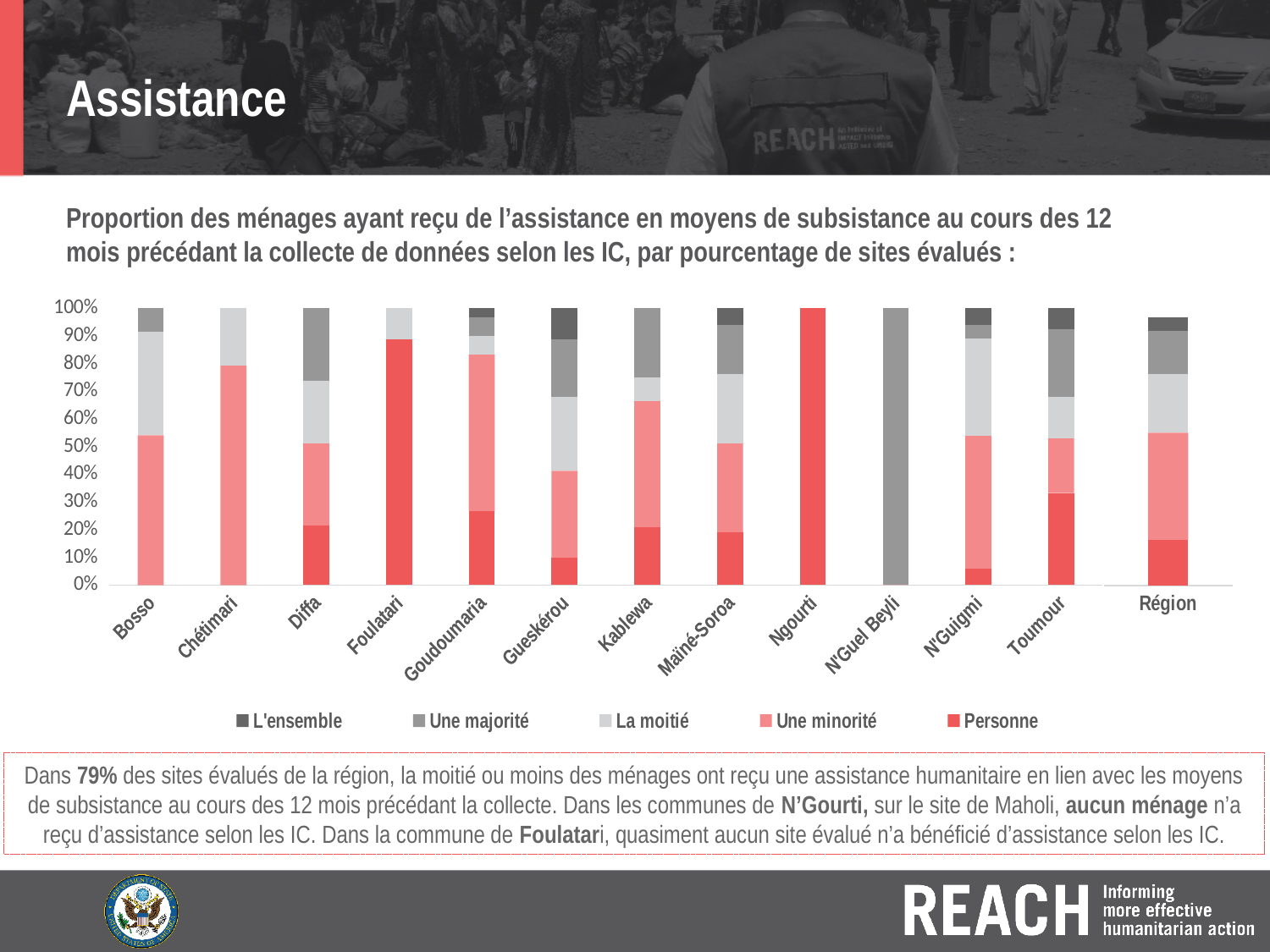
How many series does the chart legend list? 5 Which is larger, the 'Personne' value for Toumour or for Kablewa? Toumour Is the 'Personne' value for Diffa greater or less than 30%? less Which is larger, the 'Personne' value for Foulatari or for Diffa? Foulatari How many categories are shown along the x axis of the chart? 13 Is the 'Personne' value for Foulatari greater or less than 80%? greater What is the value of the 'Une majorité' series for N'Guel Beyli? 100% Is the 'Personne' value for Gueskérou greater or less than 20%? less What kind of chart is shown on the slide? Stacked bar chart Which category has the highest value for the 'Personne' series? Ngourti What is the value of the 'Personne' series for Ngourti? 100% Which series in the legend is shown in red? Personne